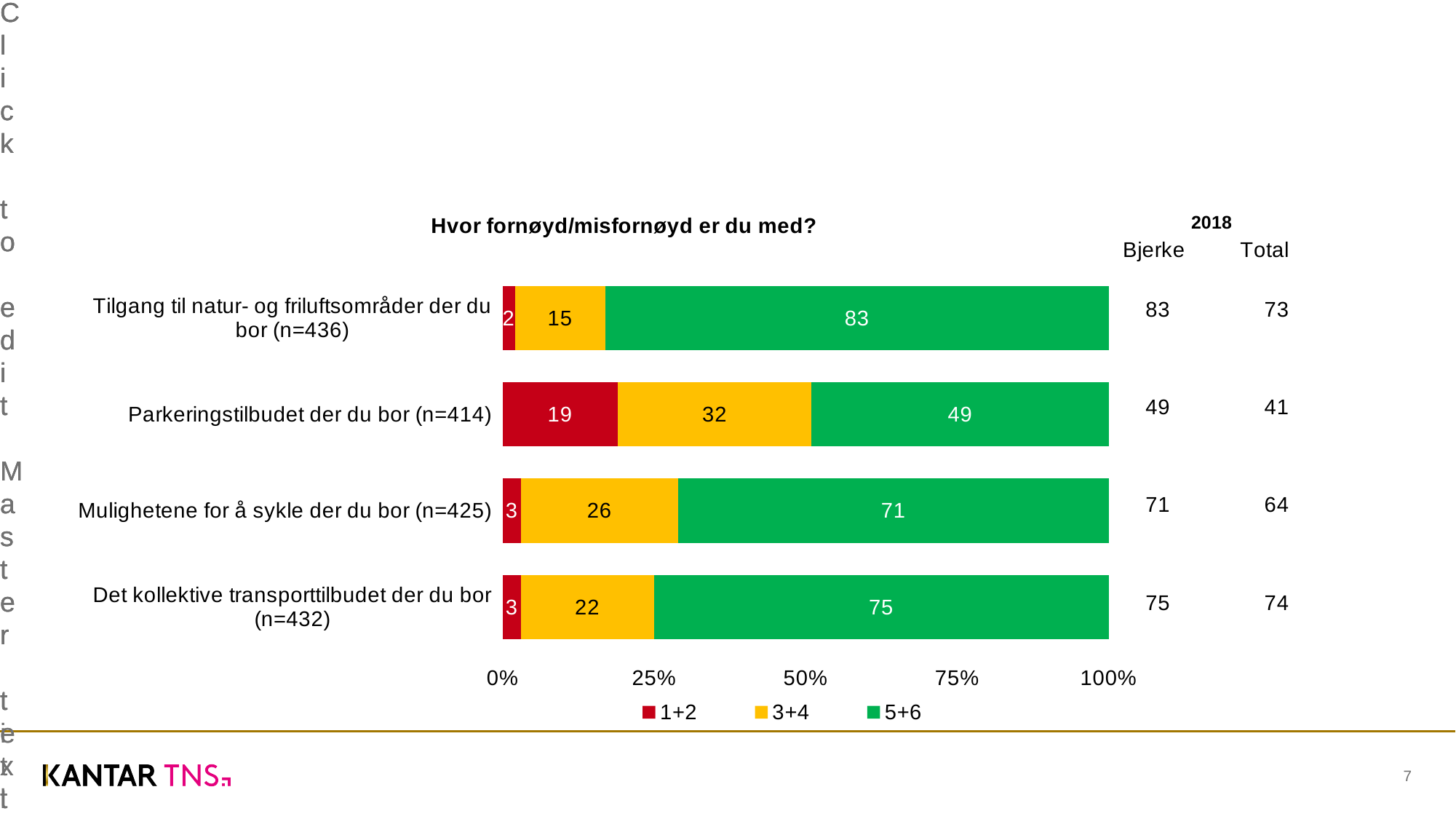
What is the title of the chart? Hvor fornøyd/misfornøyd er du med? What is the value of the 1+2 segment for "Parkeringstilbudet der du bor (n=414)"? 19 What type of chart is shown on the slide? Stacked bar chart Which is larger: the 3+4 value for "Parkeringstilbudet der du bor (n=414)" or the 3+4 value for "Det kollektive transporttilbudet der du bor (n=432)"? Parkeringstilbudet der du bor (n=414) Which category has the lowest 5+6 value? Parkeringstilbudet der du bor (n=414) What is the difference between the 5+6 values for "Det kollektive transporttilbudet der du bor (n=432)" and "Mulighetene for å sykle der du bor (n=425)"? 4 What is the value of the 5+6 segment for "Tilgang til natur- og friluftsområder der du bor (n=436)"? 83 What is the value of the 3+4 segment for "Mulighetene for å sykle der du bor (n=425)"? 26 How many categories are plotted in the chart? 4 What is the total of the stacked bar for "Parkeringstilbudet der du bor (n=414)"? 100 How many series does the legend list? 3 Which category has the highest 5+6 value? Tilgang til natur- og friluftsområder der du bor (n=436)